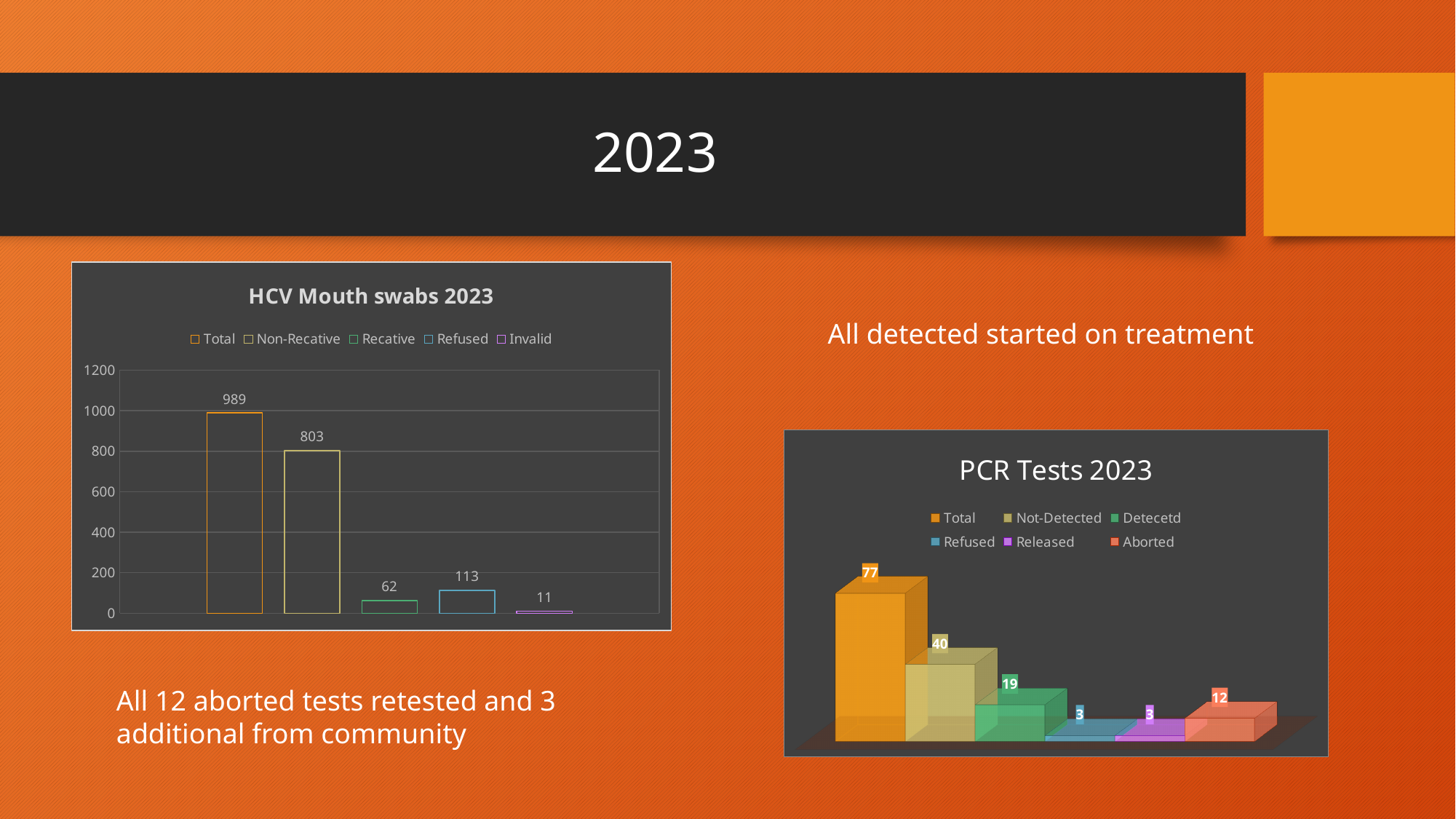
In the 'HCV Mouth swabs 2023' chart, how many series does the legend list? 5 In the 'PCR Tests 2023' chart, what is the value for Aborted? 12 In the 'PCR Tests 2023' chart, what is the difference between Not-Detected and Detecetd? 21 In the 'HCV Mouth swabs 2023' chart, what is the difference between Total and Non-Recative? 186 In the 'PCR Tests 2023' chart, what is the value for Not-Detected? 40 What kind of chart is 'PCR Tests 2023'? Bar chart In the 'HCV Mouth swabs 2023' chart, which is larger, Recative or Refused? Refused In the 'PCR Tests 2023' chart, which series has the highest value? Total In the 'HCV Mouth swabs 2023' chart, what is the value for Non-Recative? 803 In the 'HCV Mouth swabs 2023' chart, which series has the lowest value? Invalid In the 'HCV Mouth swabs 2023' chart, what is the value for Refused? 113 In the 'HCV Mouth swabs 2023' chart, what is the value for Total? 989